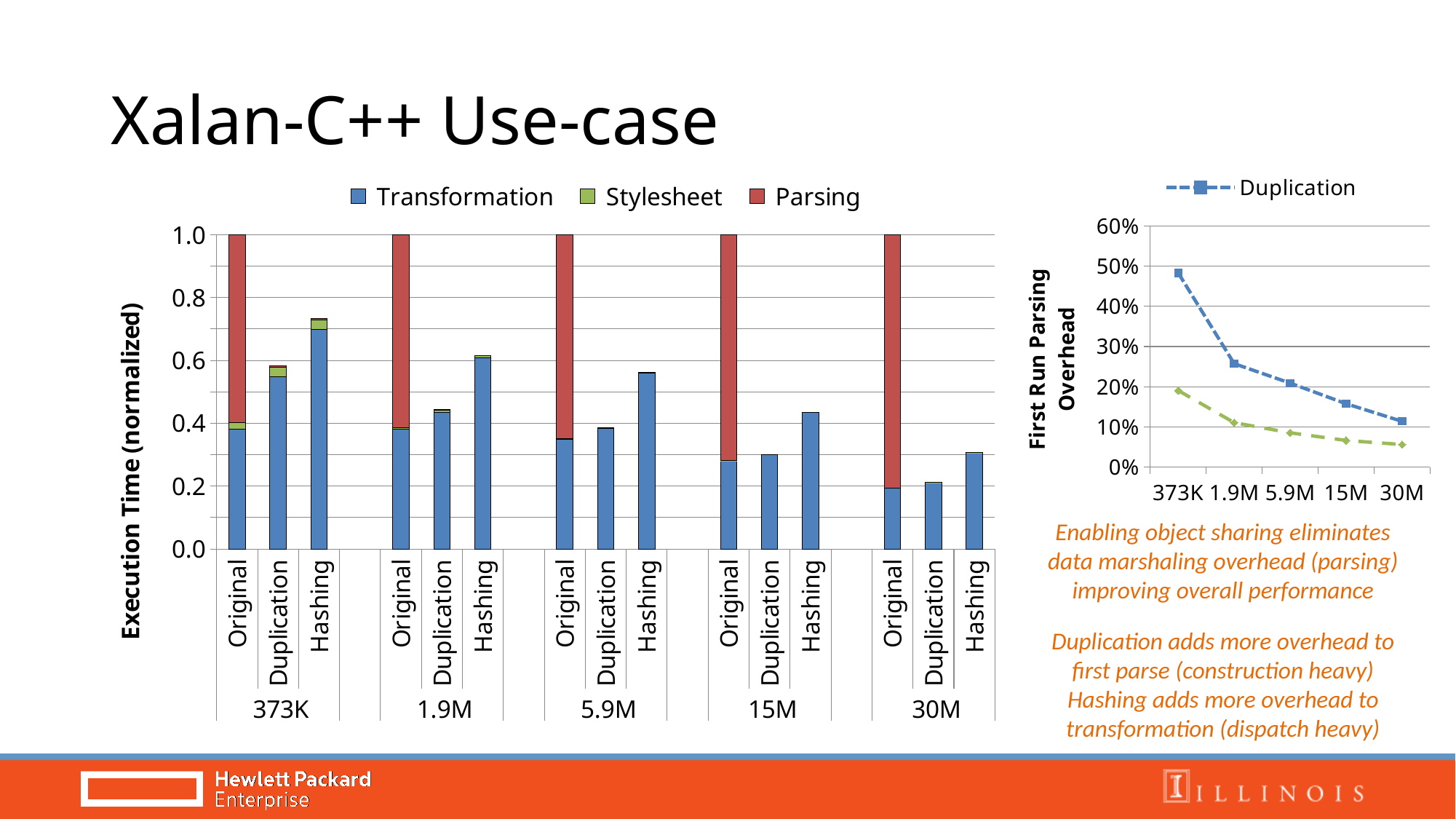
On the left chart (Execution Time (normalized)), what is the total height of the Original stacked bar for 373K? 1.0 On the left chart (Execution Time (normalized)), which is larger at 373K, the Hashing bar or the Duplication bar? Hashing On the left chart (Execution Time (normalized)), how many series does the legend list? 3 On the left chart (Execution Time (normalized)), how many bars are plotted in total? 15 On the left chart (Execution Time (normalized)), is the total for the Duplication bar at 1.9M greater or less than 0.6? less On the right chart (First Run Parsing Overhead), what kind of chart is it? line chart On the left chart (Execution Time (normalized)), what kind of chart is it? bar chart On the left chart (Execution Time (normalized)), is the total for the Hashing bar at 373K greater or less than 0.6? greater On the left chart (Execution Time (normalized)), which series is shown in red? Parsing On the right chart (First Run Parsing Overhead), is the Duplication value at 373K greater or less than 40%? greater On the left chart (Execution Time (normalized)), do the Duplication bar totals rise or fall as the input size increases from 373K to 30M? fall On the right chart (First Run Parsing Overhead), at which input size is the Duplication value highest? 373K